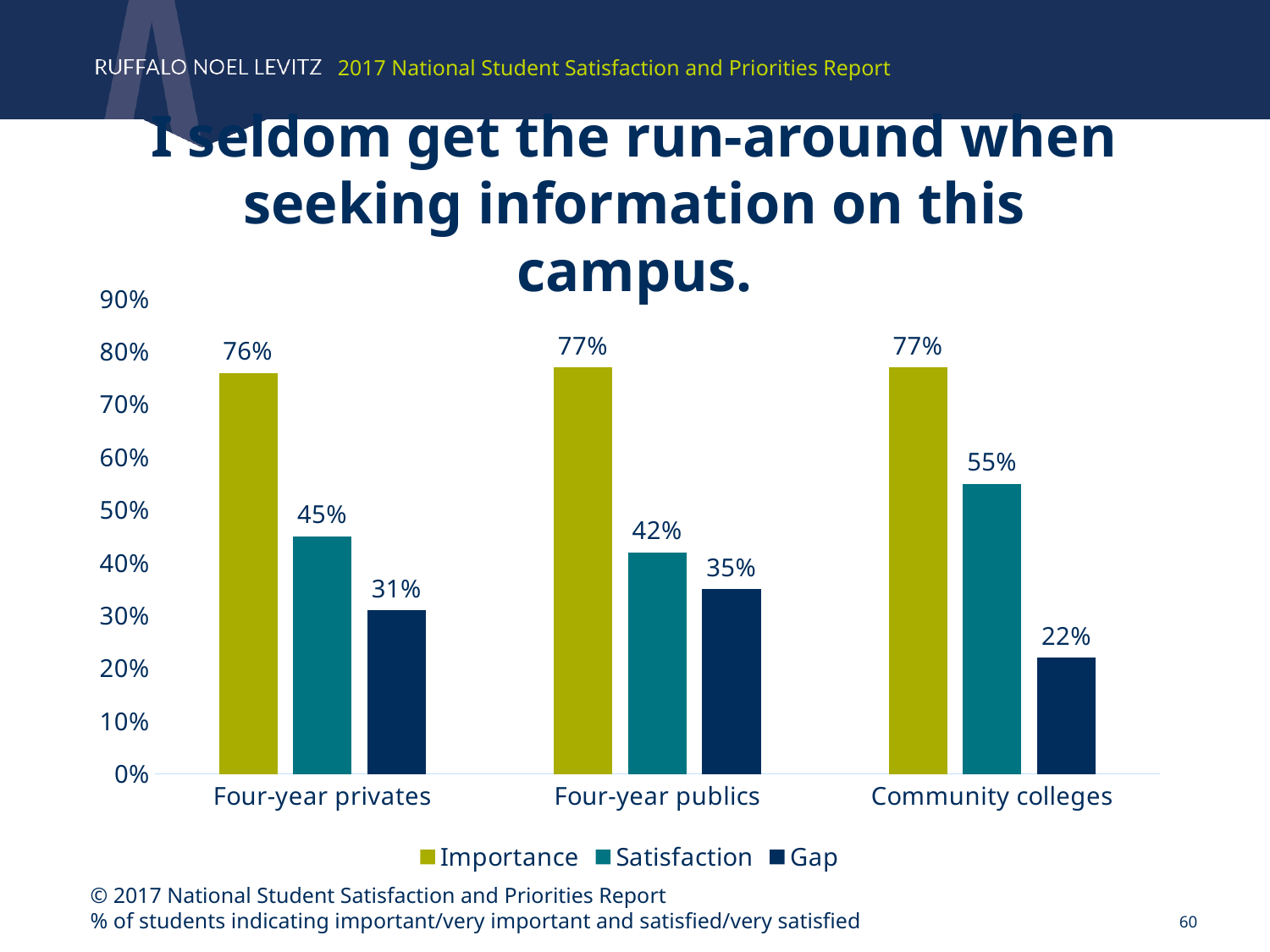
How many series does the legend list? 3 Which is larger, the Satisfaction value for Four-year privates or for Four-year publics? Four-year privates Which category has the highest Satisfaction value? Community colleges Which category has the lowest Gap value? Community colleges How many categories are shown on the x axis? 3 What kind of chart is shown on the slide? bar chart What is the Importance value for Four-year privates? 76% What is the Gap value for Four-year publics? 35% What is the Satisfaction value for Community colleges? 55% Which series is shown in the darkest colour in the legend? Gap Is the Gap value for Four-year privates greater or less than 40%? less What is the difference between the Importance and Satisfaction values for Four-year publics? 35%